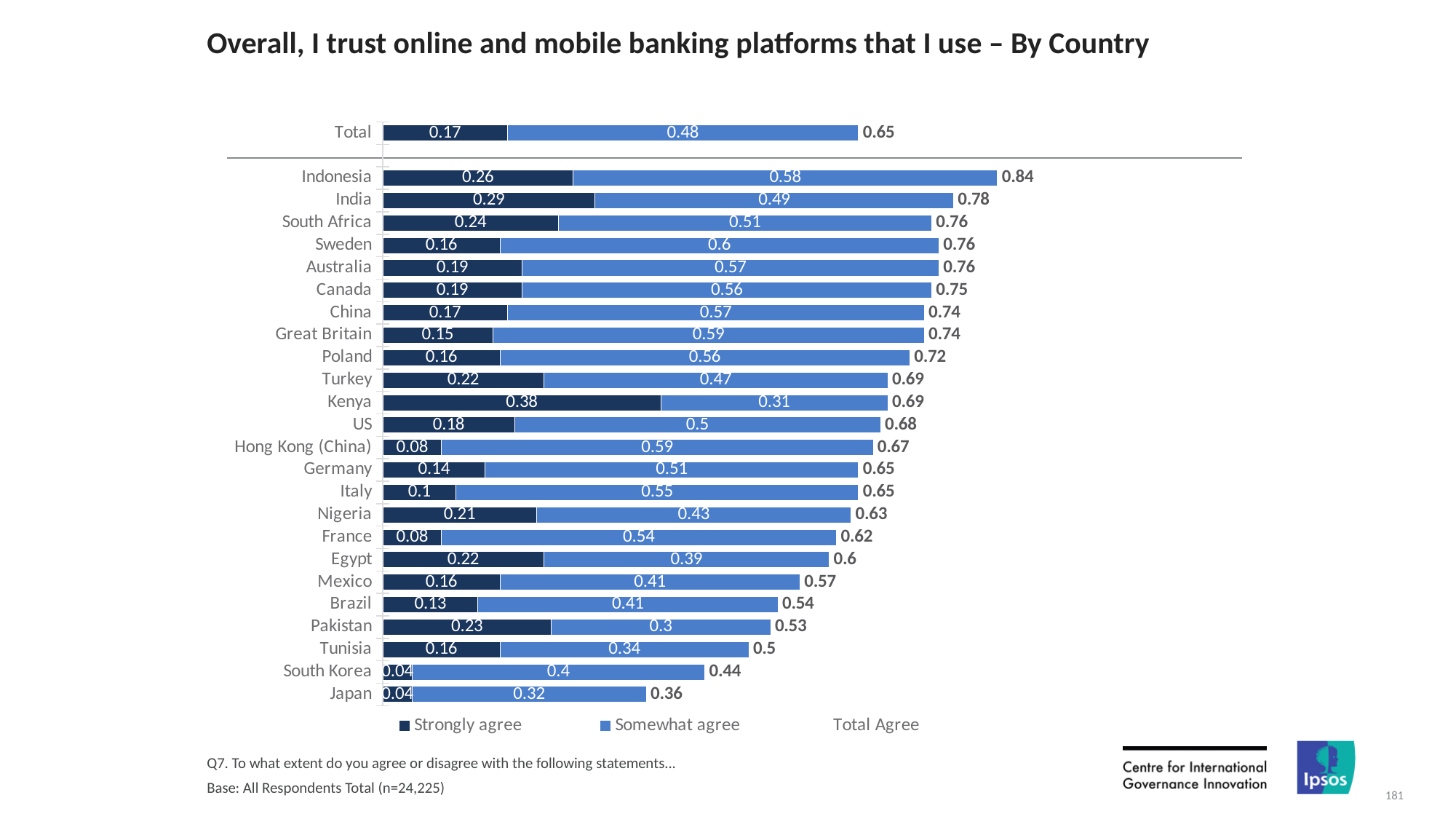
Which country has the lowest Total Agree value? Japan What is the Strongly agree value for Kenya? 0.38 What is the base size stated at the bottom of the slide? n=24,225 How many countries are listed below the Total bar? 24 How many entries does the legend list? 3 What is the difference between the Total Agree values for Indonesia and Japan? 0.48 What is the Somewhat agree value for Sweden? 0.6 Which has a larger Somewhat agree value, Hong Kong (China) or Egypt? Hong Kong (China) What is the Total Agree value for the Total row? 0.65 What is the Total Agree value for Indonesia? 0.84 Which country has the highest Strongly agree value? Kenya What kind of chart is shown on the slide? Stacked bar chart